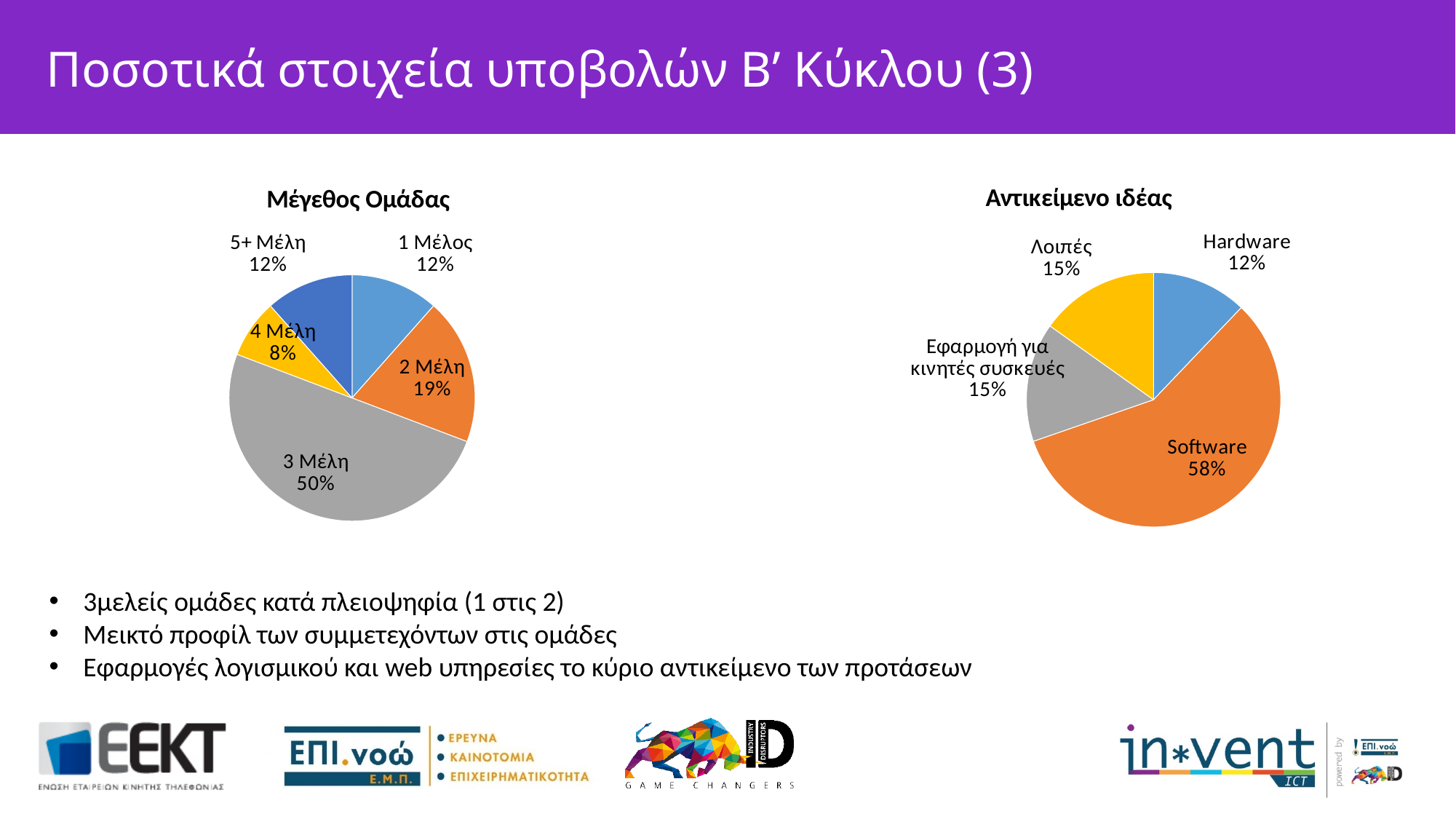
In the 'Μέγεθος Ομάδας' chart, what is the difference between '3 Μέλη' and '2 Μέλη'? 31% In the 'Αντικείμενο ιδέας' chart, what is the difference between 'Software' and 'Hardware'? 46% In the 'Αντικείμενο ιδέας' chart, what share of the pie is 'Software'? 58% In the 'Μέγεθος Ομάδας' chart, which category has the largest slice? 3 Μέλη In the 'Μέγεθος Ομάδας' chart, what is the value for '2 Μέλη'? 19% In the 'Μέγεθος Ομάδας' chart, which category has the smallest slice? 4 Μέλη In the 'Μέγεθος Ομάδας' chart, what share of the pie is '3 Μέλη'? 50% In the 'Μέγεθος Ομάδας' chart, how many categories are shown? 5 In the 'Αντικείμενο ιδέας' chart, what is the value for 'Hardware'? 12% In the 'Αντικείμενο ιδέας' chart, which is larger, 'Software' or 'Λοιπές'? Software In the 'Αντικείμενο ιδέας' chart, how many categories are shown? 4 What kind of chart is 'Αντικείμενο ιδέας'? Pie chart